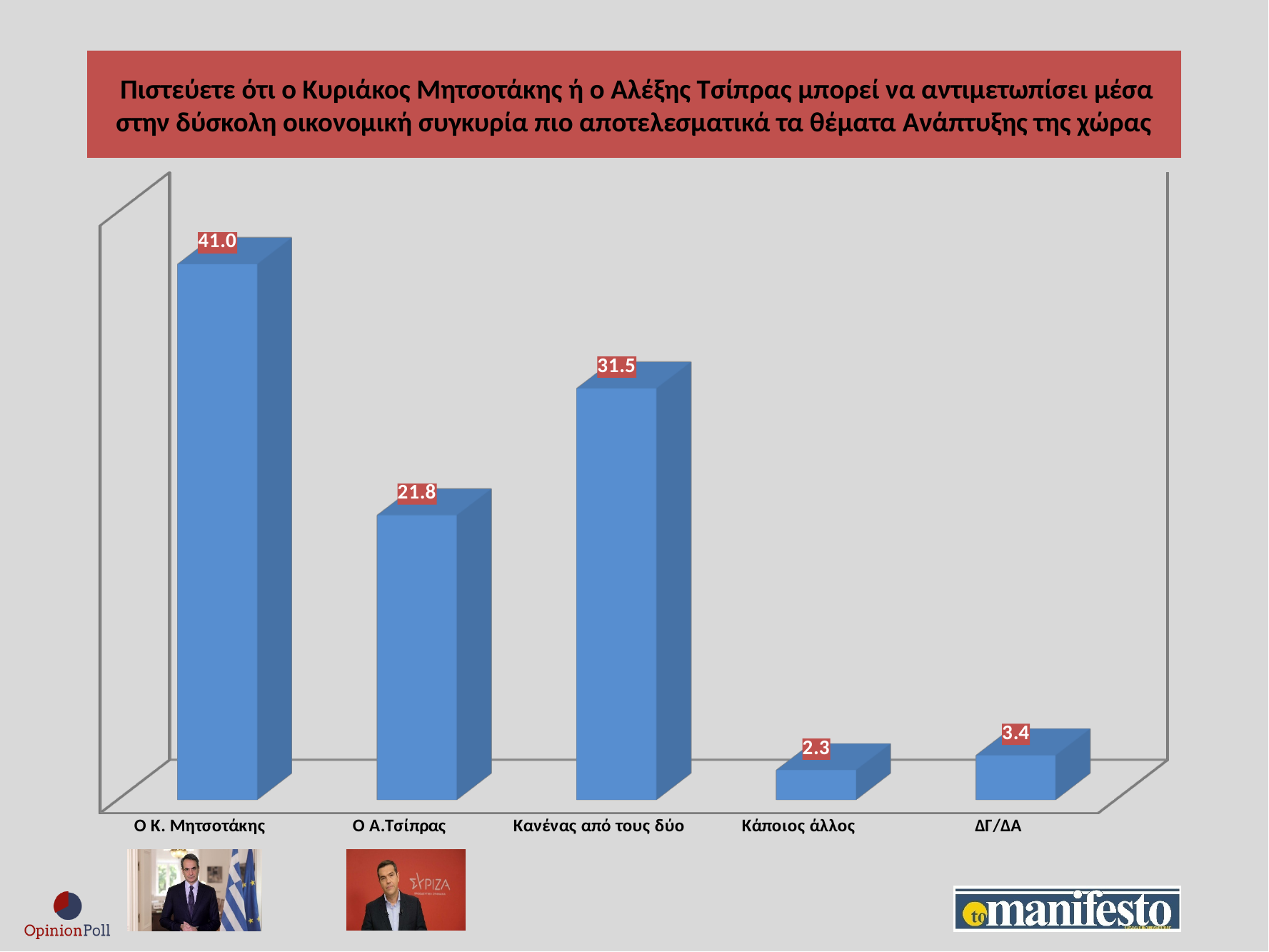
What is the difference between the values for Ο Κ. Μητσοτάκης and Ο Α.Τσίπρας? 19.2 Which is larger, the value for Ο Α.Τσίπρας or the value for Κανένας από τους δύο? Κανένας από τους δύο What is the value for Ο Α.Τσίπρας? 21.8 What kind of chart is shown on the slide? Bar chart What is the value for Κανένας από τους δύο? 31.5 How many categories are shown in the chart? 5 What is the difference between the values for ΔΓ/ΔΑ and Κάποιος άλλος? 1.1 What is the value for Κάποιος άλλος? 2.3 Which category has the lowest value? Κάποιος άλλος Which category has the highest value? Ο Κ. Μητσοτάκης What is the value for ΔΓ/ΔΑ? 3.4 What is the value for Ο Κ. Μητσοτάκης? 41.0